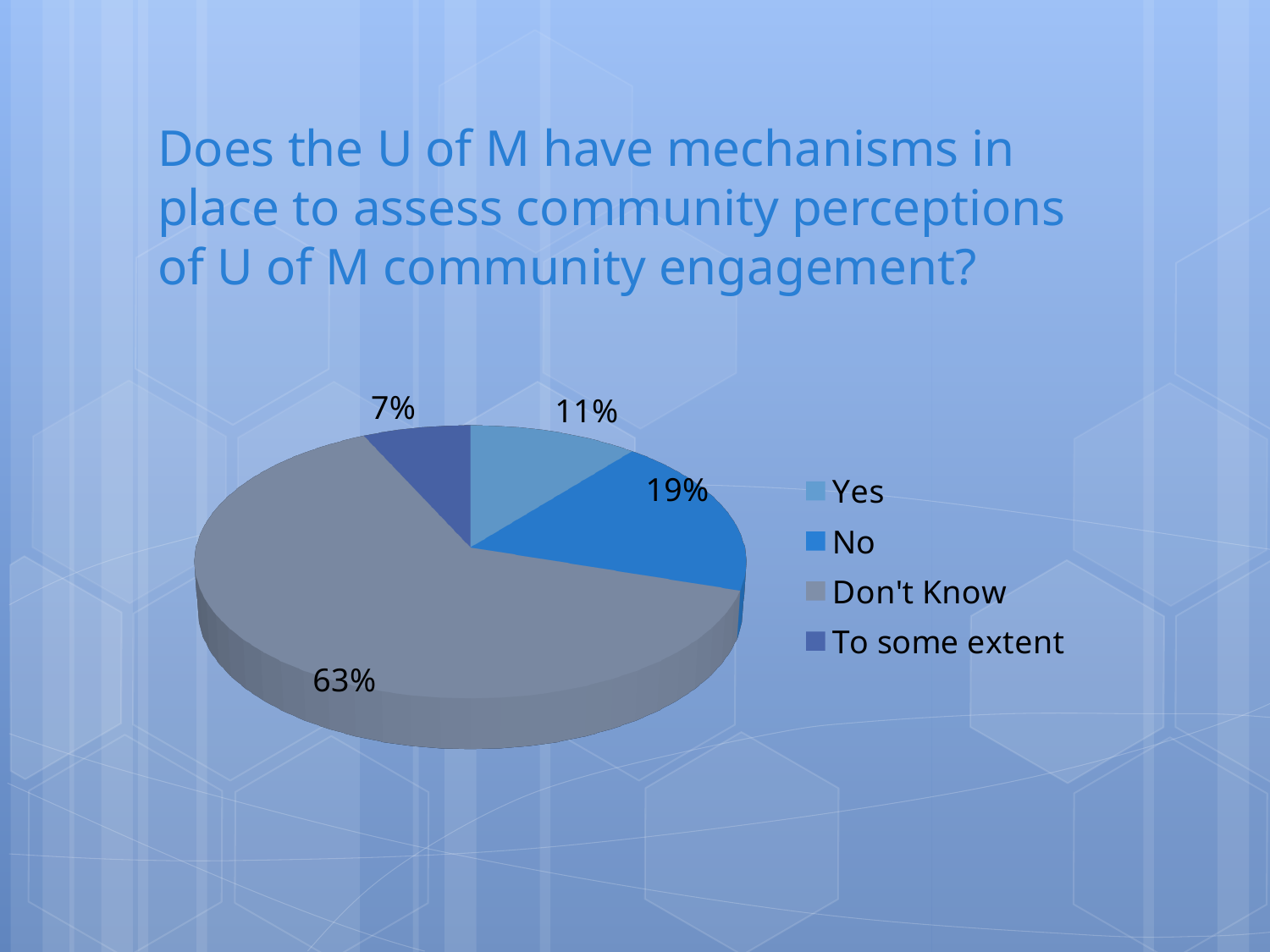
Which colour represents "Don't Know" in the legend? Grey Which is larger, the share for "No" or the share for "Yes"? No What percentage of respondents answered "Don't Know"? 63% What percentage of respondents answered "To some extent"? 7% What is the difference in percentage points between "No" and "Yes"? 8 What percentage of respondents answered "Yes"? 11% What percentage of respondents answered "No"? 19% What is the combined share of "Yes" and "To some extent"? 18% Which response has the largest share of the pie? Don't Know How many response categories does the pie chart show? 4 Which response has the smallest share of the pie? To some extent What kind of chart is shown on the slide? Pie chart